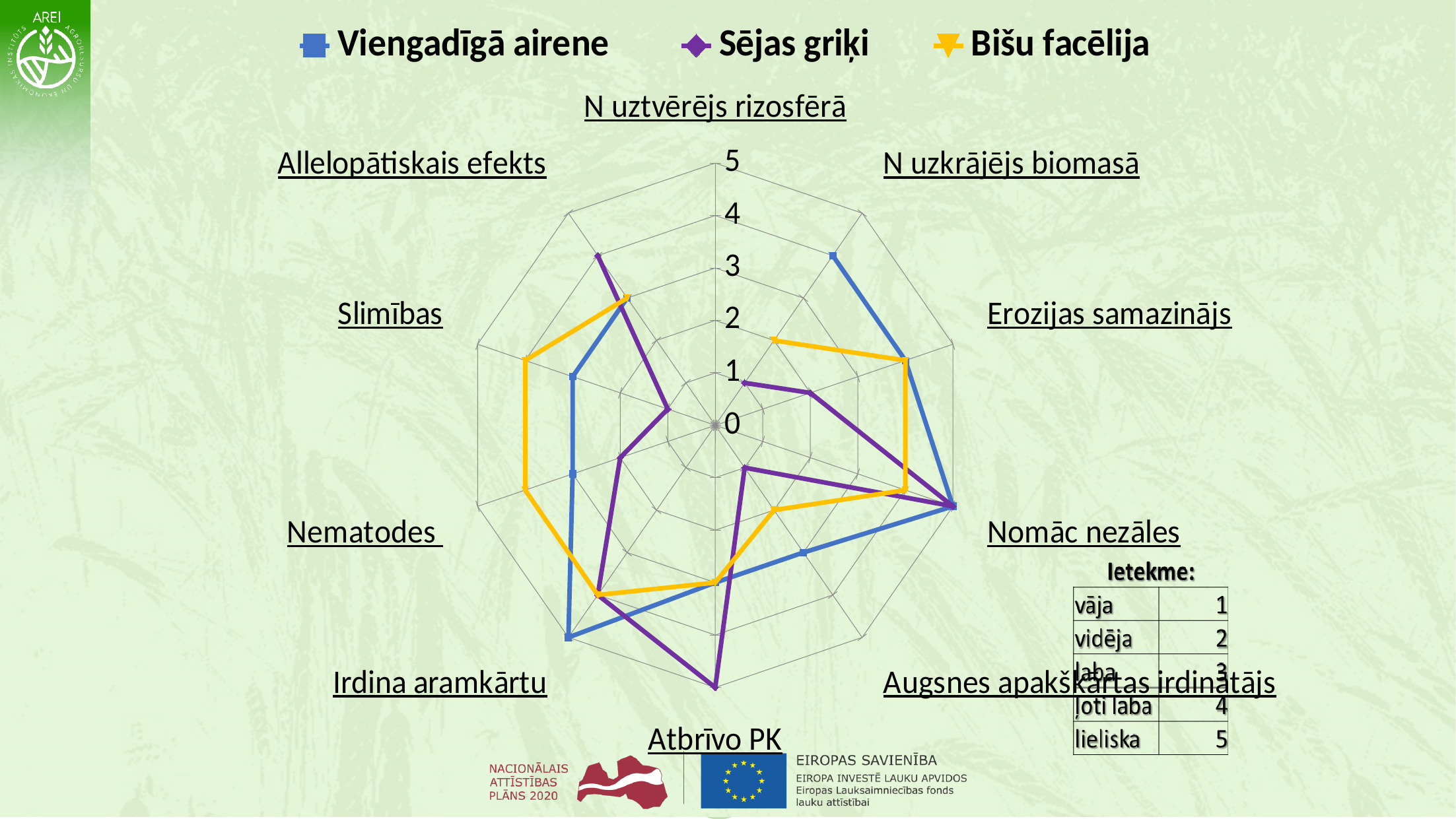
Which series has the lowest value on the Slimības axis? Sējas griķi How many axes (categories) does the radar chart have? 10 Which series has the highest value on the Nematodes axis? Bišu facēlija Which series has the highest value on the Irdina aramkārtu axis? Viengadīgā airene Is the value for Sējas griķi on the Slimības axis greater or less than 2? less What kind of chart is shown on the slide? Radar chart How many series does the legend list? 3 Which series is plotted in purple? Sējas griķi Is the value for Sējas griķi on the Atbrīvo PK axis greater or less than 4? greater On the Augsnes apakškārtas irdinātājs axis, which is larger: Viengadīgā airene or Sējas griķi? Viengadīgā airene Which series has the highest value on the Atbrīvo PK axis? Sējas griķi What is the highest value shown on the chart's scale? 5